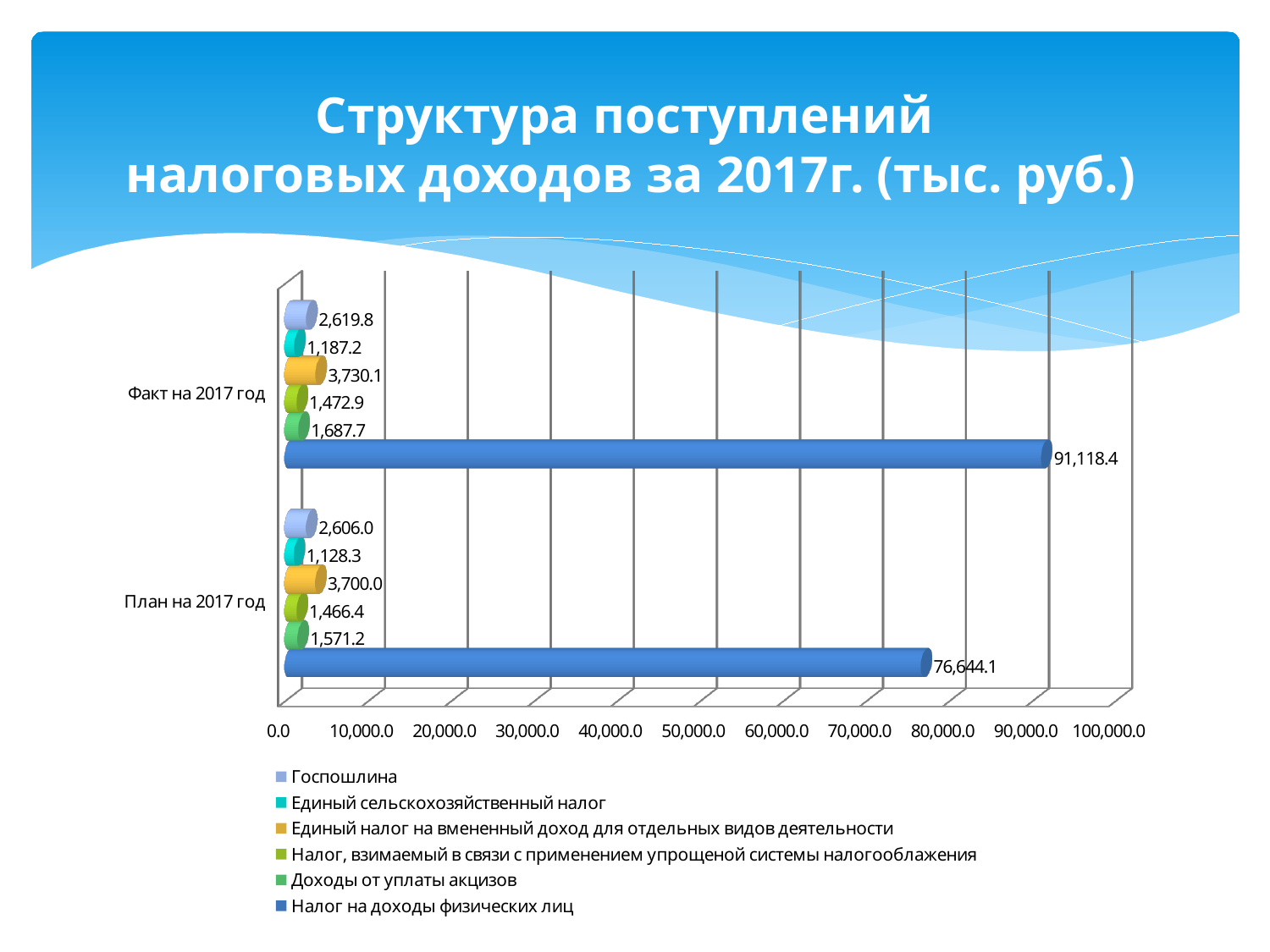
Which series has the lowest value for План на 2017 год? Единый сельскохозяйственный налог What is the value of Госпошлина for План на 2017 год? 2,606.0 Which series has the highest value for Факт на 2017 год? Налог на доходы физических лиц How many series does the legend list? 6 What is the difference between the Факт на 2017 год and План на 2017 год values for Налог на доходы физических лиц? 14,474.3 What is the value of Единый налог на вмененный доход для отдельных видов деятельности for Факт на 2017 год? 3,730.1 What is the value of Налог на доходы физических лиц for Факт на 2017 год? 91,118.4 What kind of chart is shown on the slide? Bar chart What is the value of Доходы от уплаты акцизов for План на 2017 год? 1,571.2 What is the value of Налог на доходы физических лиц for План на 2017 год? 76,644.1 Which is larger: Единый сельскохозяйственный налог for Факт на 2017 год or for План на 2017 год? Факт на 2017 год How many categories are shown on the vertical axis? 2